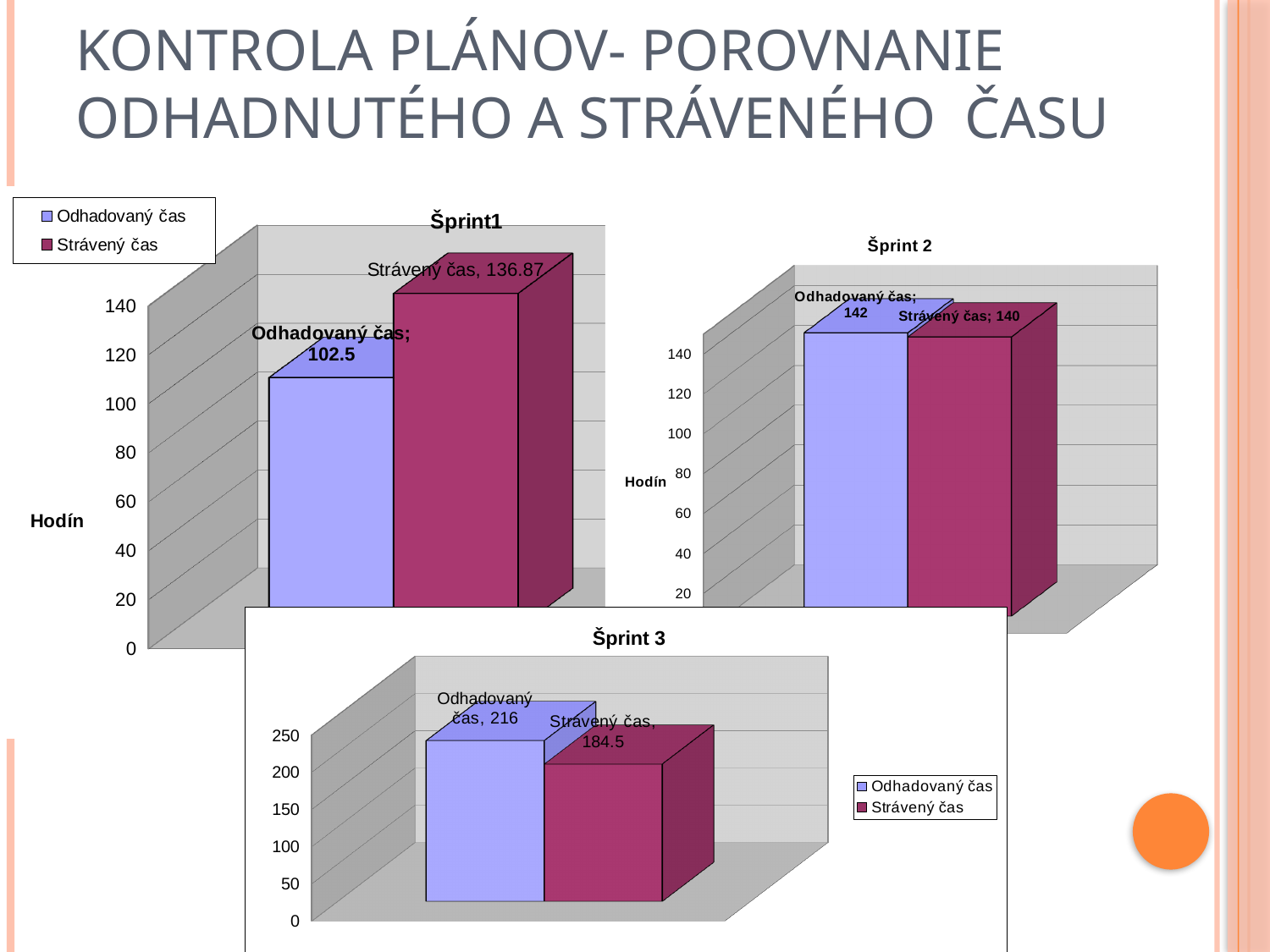
What kind of chart is the Šprint 2 chart? bar chart In the Šprint1 chart, what is the value for Odhadovaný čas? 102.5 In the Šprint 2 chart, what is the value for Odhadovaný čas? 142 In the Šprint 3 chart, what is the value for Odhadovaný čas? 216 In the Šprint1 chart, what is the difference between Strávený čas and Odhadovaný čas? 34.37 In the Šprint1 chart, what is the value for Strávený čas? 136.87 In the Šprint 3 chart, which is larger, Odhadovaný čas or Strávený čas? Odhadovaný čas In the Šprint 3 chart, what is the difference between Odhadovaný čas and Strávený čas? 31.5 In the Šprint 3 chart, what is the value for Strávený čas? 184.5 In the Šprint1 chart, which is larger, Odhadovaný čas or Strávený čas? Strávený čas In the Šprint 2 chart, what is the value for Strávený čas? 140 How many series does the legend of the Šprint 3 chart list? 2